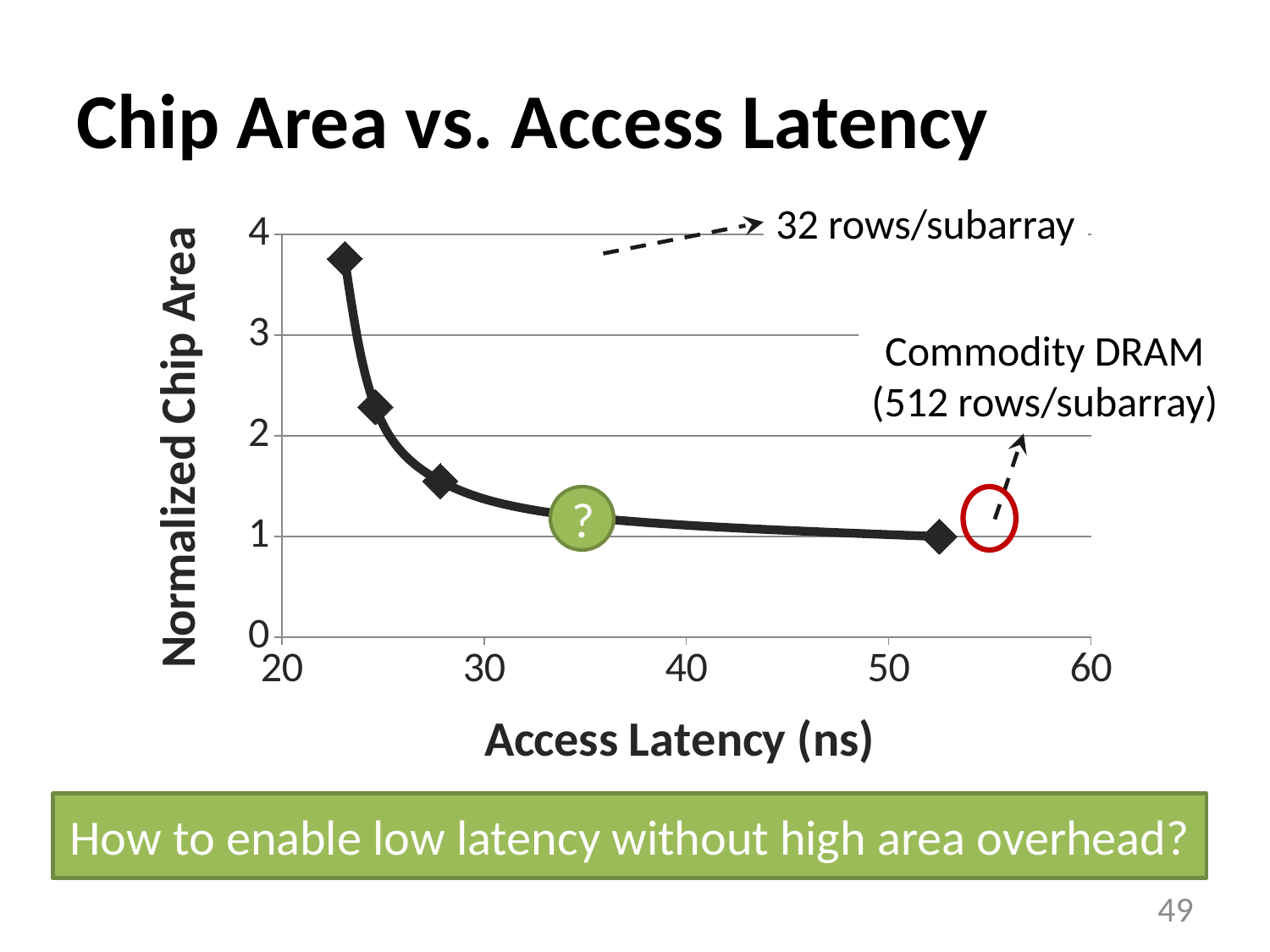
Is the access latency of the 32 rows/subarray point greater or less than 30 ns? less Is the normalized chip area for the 32 rows/subarray point greater or less than 3? greater What is the title of the y axis? Normalized Chip Area Is the normalized chip area for Commodity DRAM (512 rows/subarray) greater or less than 2? less What is the title of the x axis? Access Latency (ns) As access latency increases along the x axis, does the normalized chip area rise or fall? fall Which labeled configuration has the lowest normalized chip area? Commodity DRAM (512 rows/subarray) Which has a larger normalized chip area: 32 rows/subarray or Commodity DRAM (512 rows/subarray)? 32 rows/subarray Which labeled configuration has the highest normalized chip area? 32 rows/subarray What kind of chart is shown on the slide? line chart